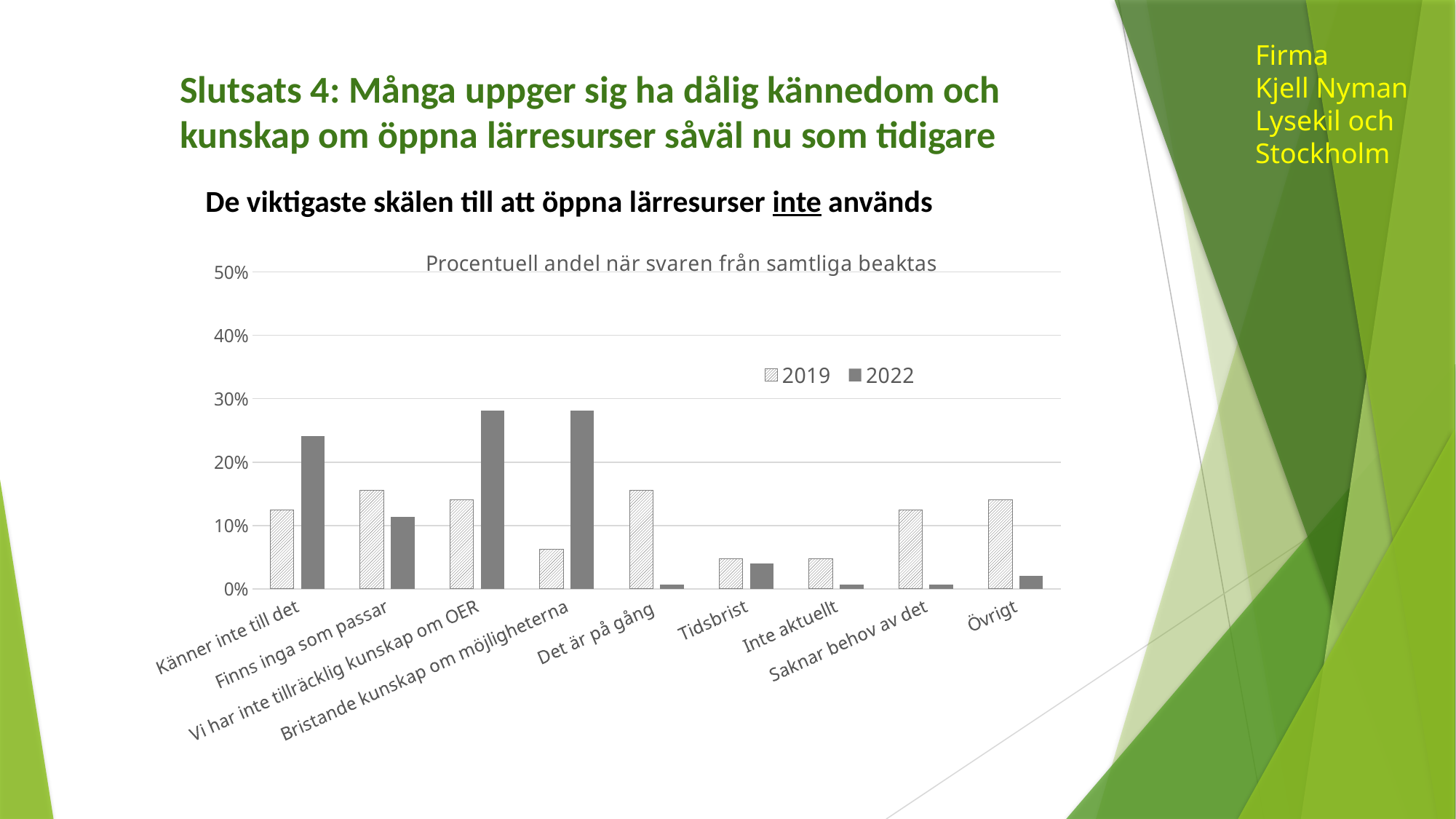
For "Känner inte till det", which series has the larger value, 2019 or 2022? 2022 For "Finns inga som passar", which series has the larger value, 2019 or 2022? 2019 Which series are listed in the chart legend? 2019 and 2022 Is the 2022 value for "Vi har inte tillräcklig kunskap om OER" greater or less than 20%? greater For "Övrigt", which series has the larger value, 2019 or 2022? 2019 How many categories are shown on the x axis of the chart? 9 What kind of chart is shown on the slide? Bar chart Is the 2022 value for "Känner inte till det" greater or less than 20%? greater Is the 2019 value for "Bristande kunskap om möjligheterna" greater or less than 10%? less What is the title printed inside the chart area? Procentuell andel när svaren från samtliga beaktas How many series does the chart legend list? 2